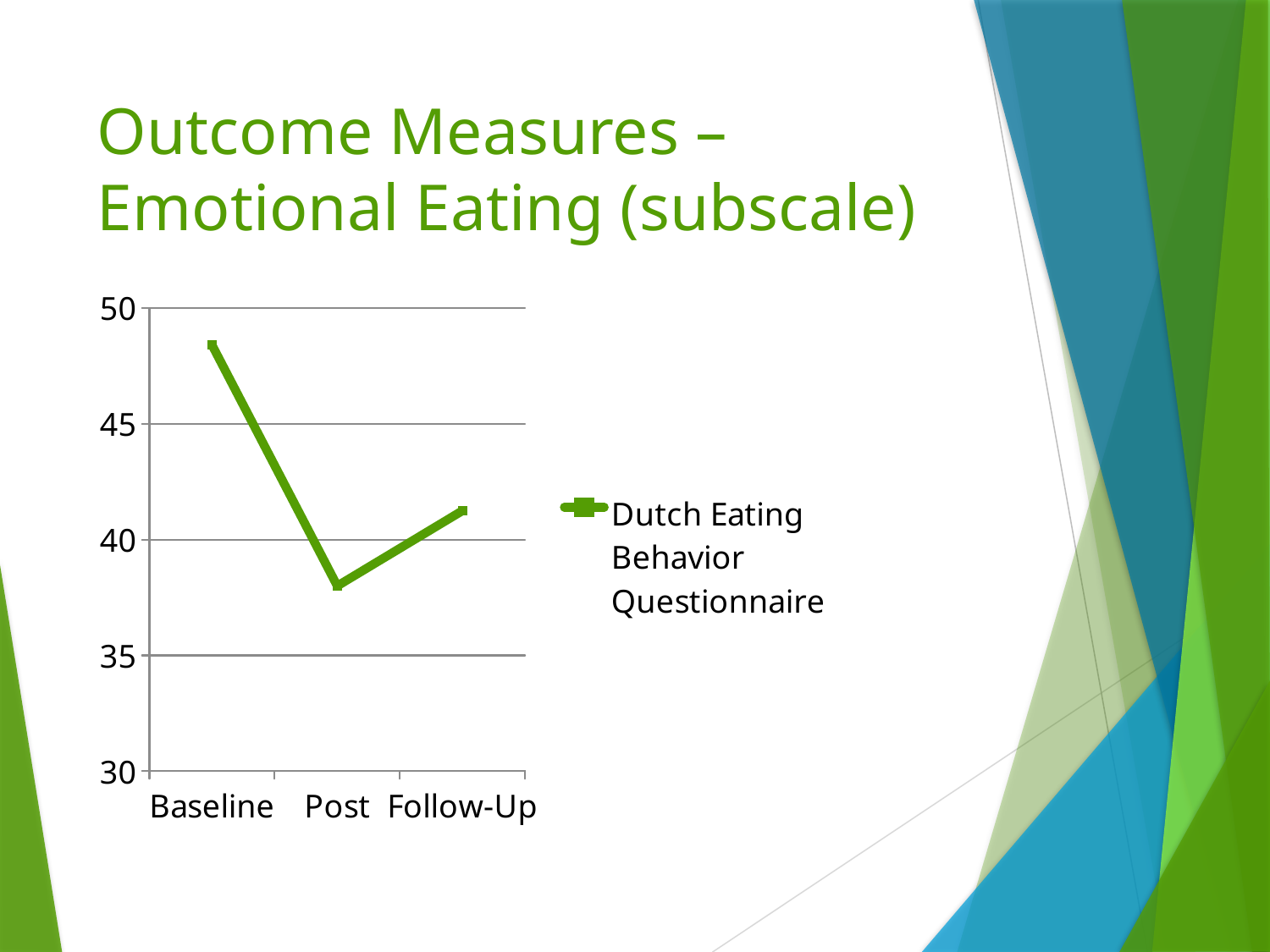
How many time points are plotted on the x axis? 3 Does the score rise or fall from Baseline to Post? Fall Is the value at Post greater or less than 40? less Is the value at Baseline greater or less than 45? greater At which time point is the Dutch Eating Behavior Questionnaire score lowest? Post Which is larger, the score at Post or the score at Follow-Up? Follow-Up At which time point is the Dutch Eating Behavior Questionnaire score highest? Baseline What kind of chart is shown on the slide? Line chart Which is larger, the score at Baseline or the score at Follow-Up? Baseline What is the name of the series shown in the legend? Dutch Eating Behavior Questionnaire Is the value at Follow-Up greater or less than 40? greater How many series does the legend list? 1